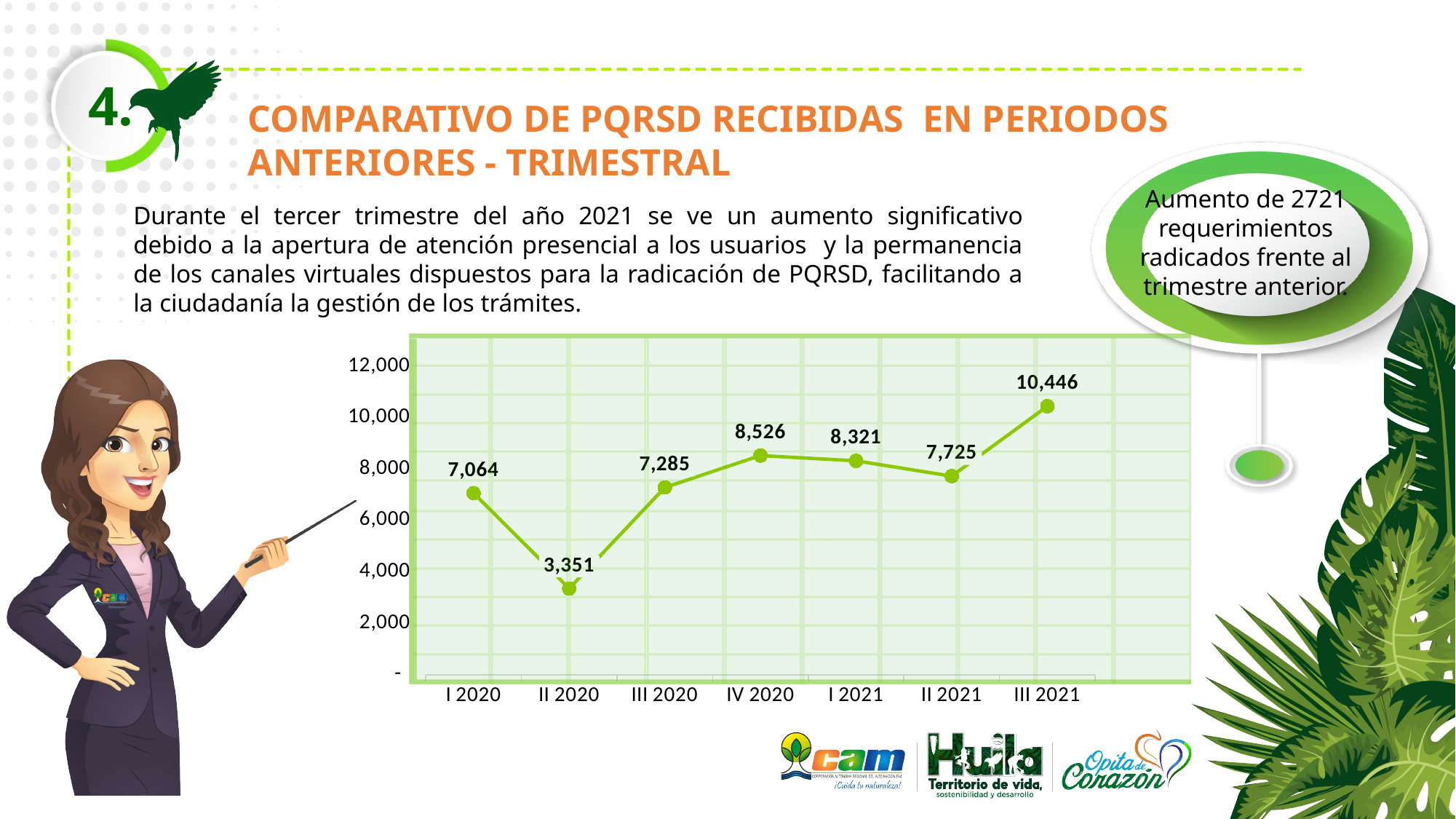
Is the value for III 2020 greater or less than 8,000? less What is the difference between the values for I 2020 and II 2020? 3,713 Which quarter has the lowest value? II 2020 What value is plotted for IV 2020? 8,526 Which is larger, the value for IV 2020 or the value for I 2021? IV 2020 How many quarters are plotted on the x axis? 7 Does the value rise or fall from II 2021 to III 2021? rise Which quarter has the highest value? III 2021 What is the difference between the values for III 2021 and II 2021? 2,721 What value is plotted for III 2021? 10,446 What value is plotted for II 2020? 3,351 What kind of chart is shown on the slide? line chart